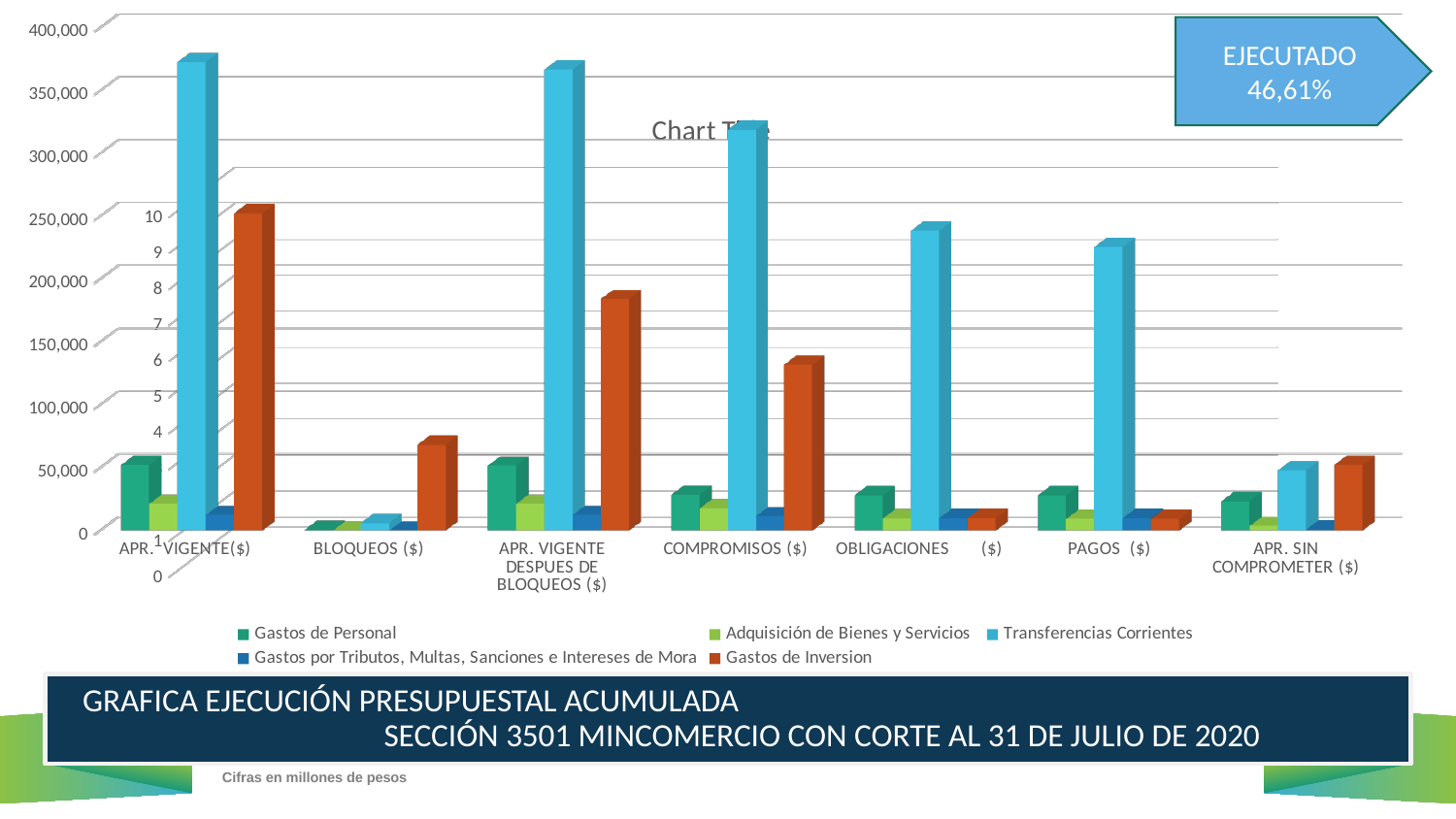
How many series does the chart legend list? 5 Is the Transferencias Corrientes value for APR. VIGENTE($) greater or less than 300,000? greater How many categories are shown along the x axis of the chart? 7 Which is larger: the Transferencias Corrientes value for COMPROMISOS ($) or for PAGOS ($)? COMPROMISOS ($) Is the Transferencias Corrientes value for PAGOS ($) greater or less than 200,000? greater What kind of chart is shown on the slide? bar chart What EJECUTADO percentage is shown in the callout at the top right of the slide? 46,61% Is the Gastos de Inversion value for APR. VIGENTE($) greater or less than 200,000? greater Which series has the highest value in the APR. VIGENTE($) category? Transferencias Corrientes Which is larger: the Gastos de Inversion value for COMPROMISOS ($) or for OBLIGACIONES ($)? COMPROMISOS ($) In which category is the Transferencias Corrientes value lowest? BLOQUEOS ($)